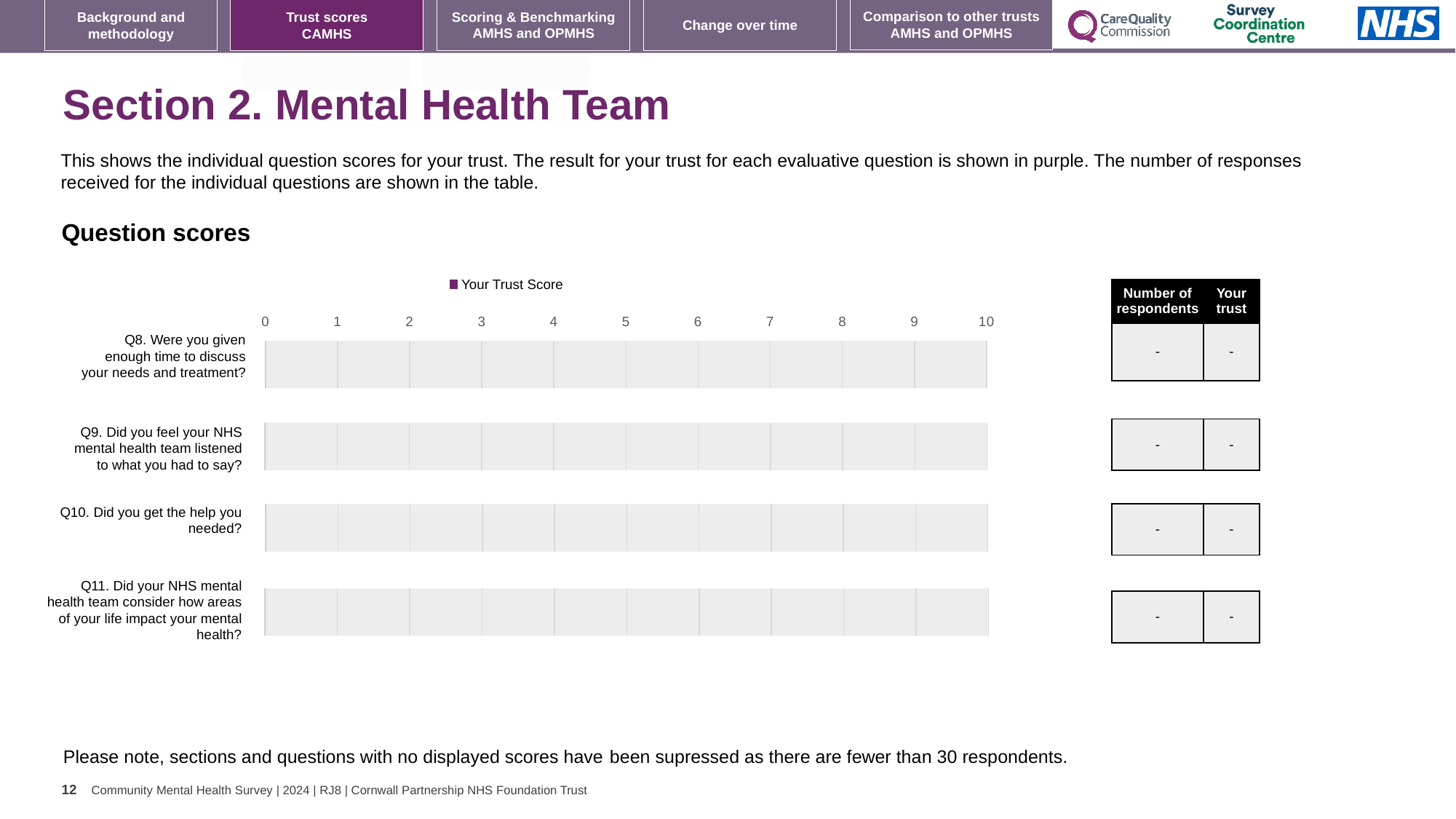
What type of chart is shown on the slide? bar chart What is the name of the series shown in the chart legend? Your Trust Score Which question label appears first (at the top) of the chart? Q8. Were you given enough time to discuss your needs and treatment? What value is shown in the 'Number of respondents' column of the table for Q8? - How many question categories are listed on the y axis of the chart? 4 Which question label appears last (at the bottom) of the chart? Q11. Did your NHS mental health team consider how areas of your life impact your mental health? How many series does the chart legend list? 1 What value is shown in the 'Your trust' column of the table for Q10? - What is the maximum value shown on the chart's x axis? 10